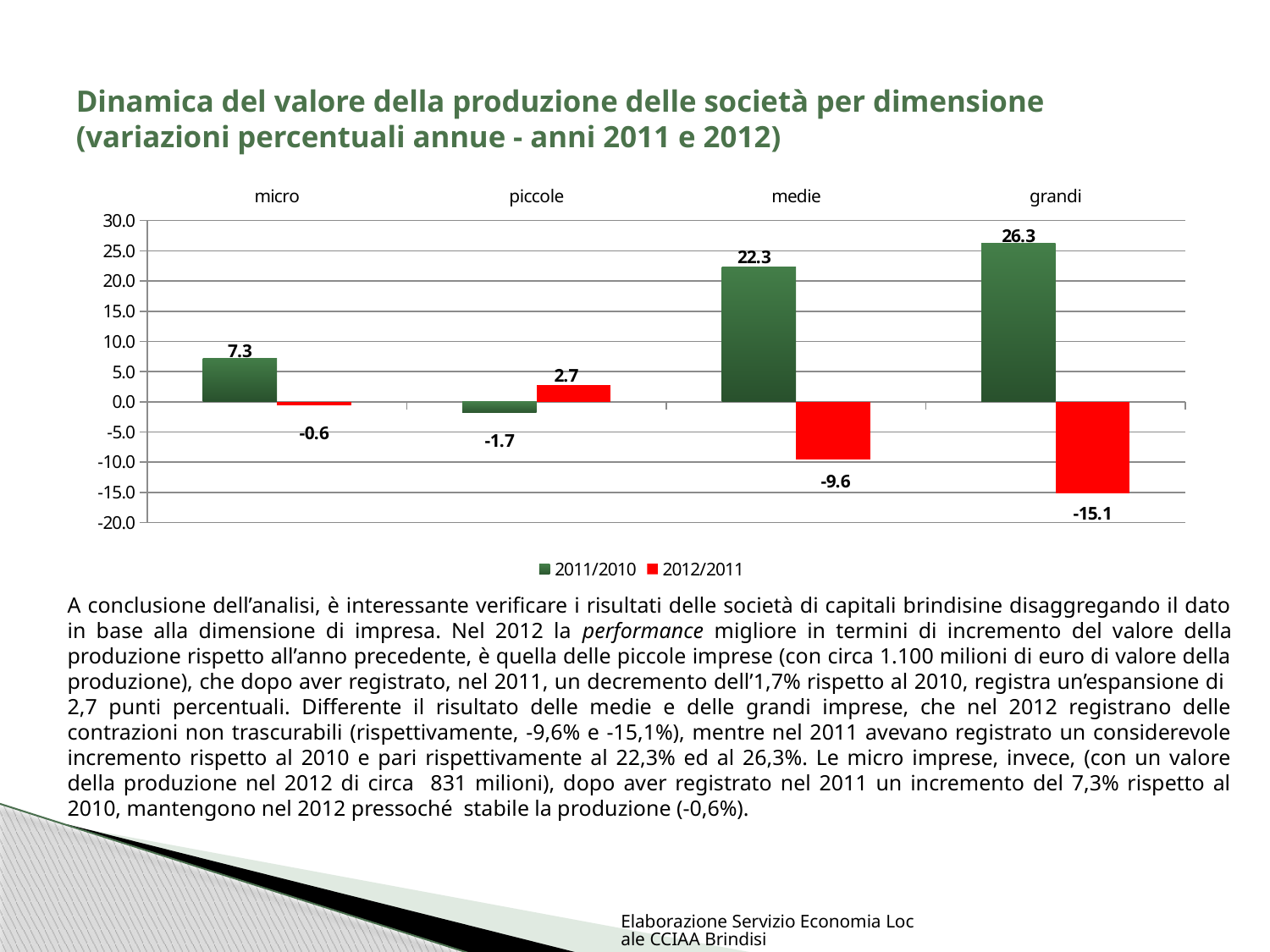
Which is larger for piccole: the 2011/2010 value or the 2012/2011 value? 2012/2011 Which category has the lowest 2012/2011 value? grandi How many series does the legend list? 2 What is the 2012/2011 value for piccole? 2.7 What kind of chart is shown on the slide? bar chart What is the 2012/2011 value for grandi? -15.1 What is the 2011/2010 value for medie? 22.3 Which category has the highest 2011/2010 value? grandi How many categories are shown on the x axis? 4 What is the 2011/2010 value for micro? 7.3 Is the 2012/2011 value for medie greater or less than -5.0? less What is the difference between the 2011/2010 and 2012/2011 values for medie? 31.9